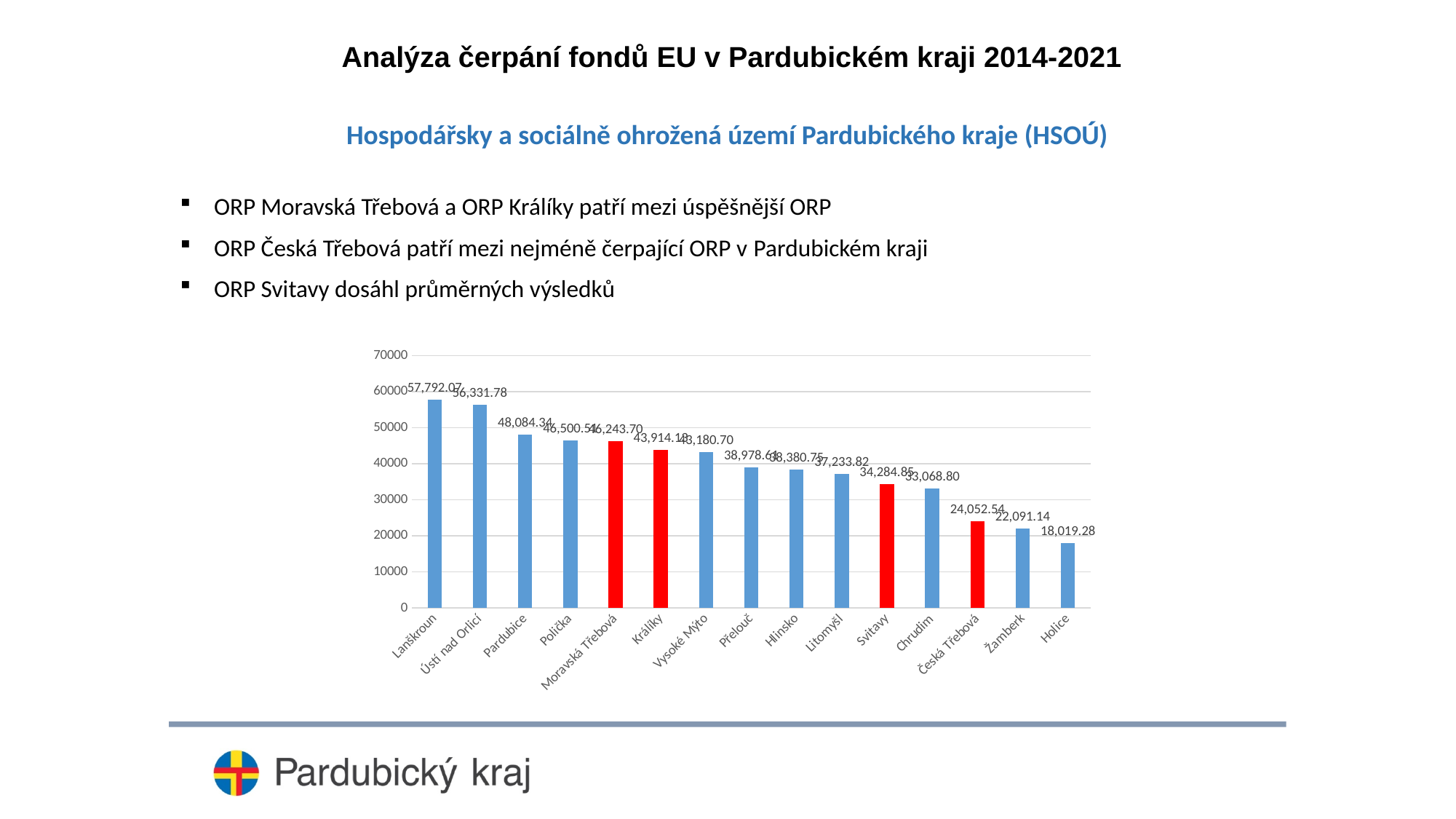
What is the value for Svitavy? 34,284.85 What is the value for Česká Třebová? 24,052.54 What type of chart is shown on the slide? bar chart Which ORP bars are coloured red on the chart? Moravská Třebová, Králíky, Svitavy, Česká Třebová How many ORP categories are plotted on the chart? 15 Which ORP has the lowest value on the chart? Holice Is the value for Žamberk greater or less than 30000? less Which is larger, the value for Pardubice or the value for Chrudim? Pardubice What is the difference between the values for Lanškroun and Holice? 39,772.79 What is the value for Lanškroun? 57,792.07 What is the value for Holice? 18,019.28 Which ORP has the highest value on the chart? Lanškroun